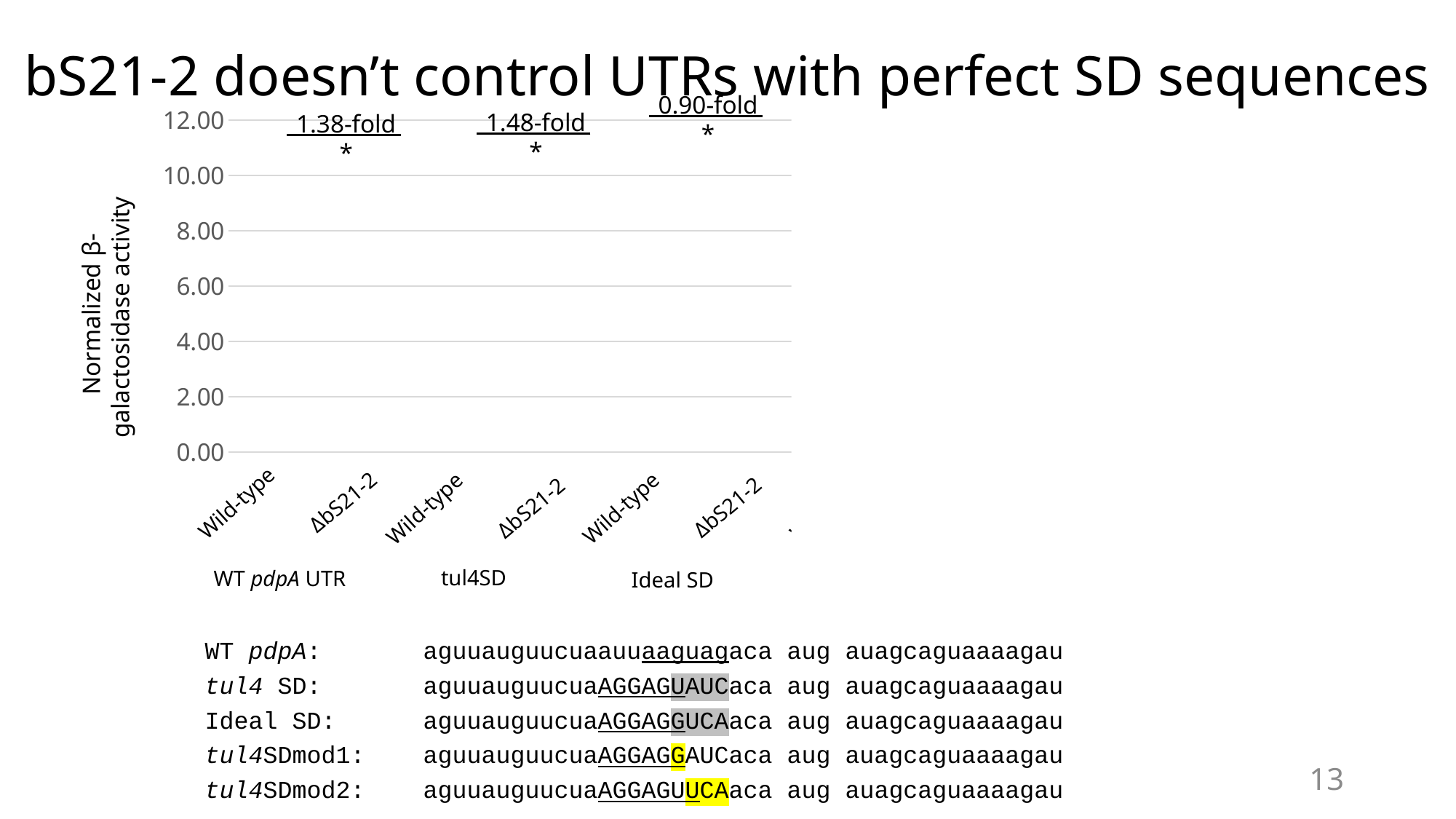
What fold change is annotated above the Ideal SD group in the chart? 0.90-fold What fold change is annotated above the WT pdpA UTR group in the chart? 1.38-fold What is the highest tick value shown on the y axis of the chart? 12.00 What fold change is annotated above the tul4SD group in the chart? 1.48-fold What is the y-axis title of the chart? Normalized β-galactosidase activity How many categories are labelled along the x axis of the chart? 6 What are the two x-axis category labels repeated within each group of the chart? Wild-type and ΔbS21-2 Is the annotated fold change for the tul4SD group larger than that for the WT pdpA UTR group? Yes Which group in the chart has the smallest annotated fold change? Ideal SD What is the difference between the annotated fold changes of the tul4SD and WT pdpA UTR groups? 0.10-fold How many UTR groups are labelled beneath the x axis of the chart? 3 Which group in the chart has the largest annotated fold change? tul4SD